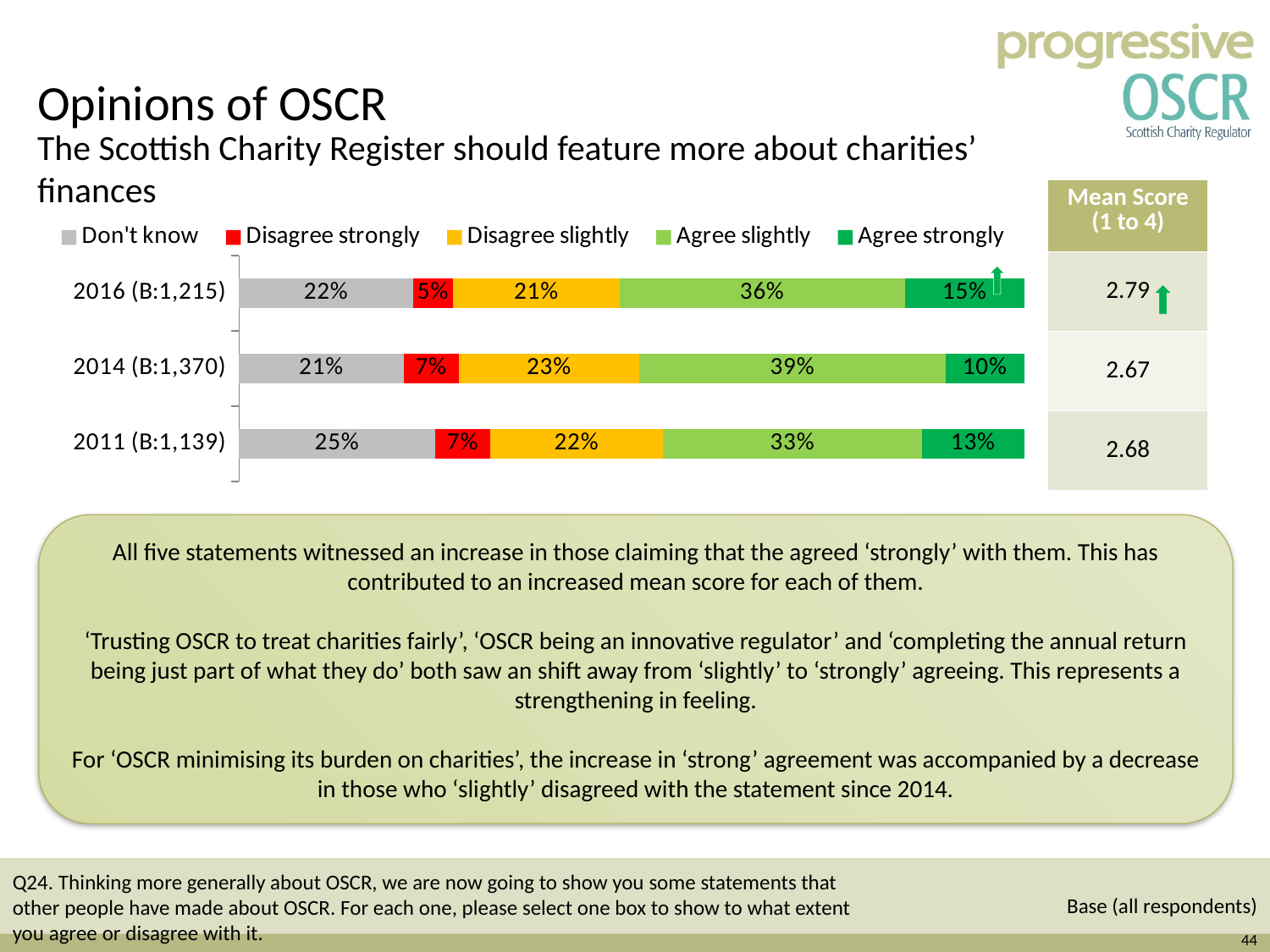
Did the 'Agree strongly' share rise or fall from 2014 (B:1,370) to 2016 (B:1,215)? Rise Which year has the lowest 'Disagree strongly' value? 2016 (B:1,215) Which year has the larger 'Don't know' share, 2011 (B:1,139) or 2016 (B:1,215)? 2011 (B:1,139) What is the 'Disagree slightly' value for 2014 (B:1,370)? 23% Which year has the highest 'Agree slightly' value? 2014 (B:1,370) How many series does the legend list? 5 What kind of chart is shown on the slide? Stacked bar chart By how many percentage points did 'Agree strongly' change between 2014 (B:1,370) and 2016 (B:1,215)? 5 percentage points What percentage of respondents in 2016 (B:1,215) agreed strongly that the Scottish Charity Register should feature more about charities' finances? 15% What is the 'Don't know' value for 2011 (B:1,139)? 25% How many years (categories) are shown in the chart? 3 What is the total of the stacked bar for 2014 (B:1,370)? 100%